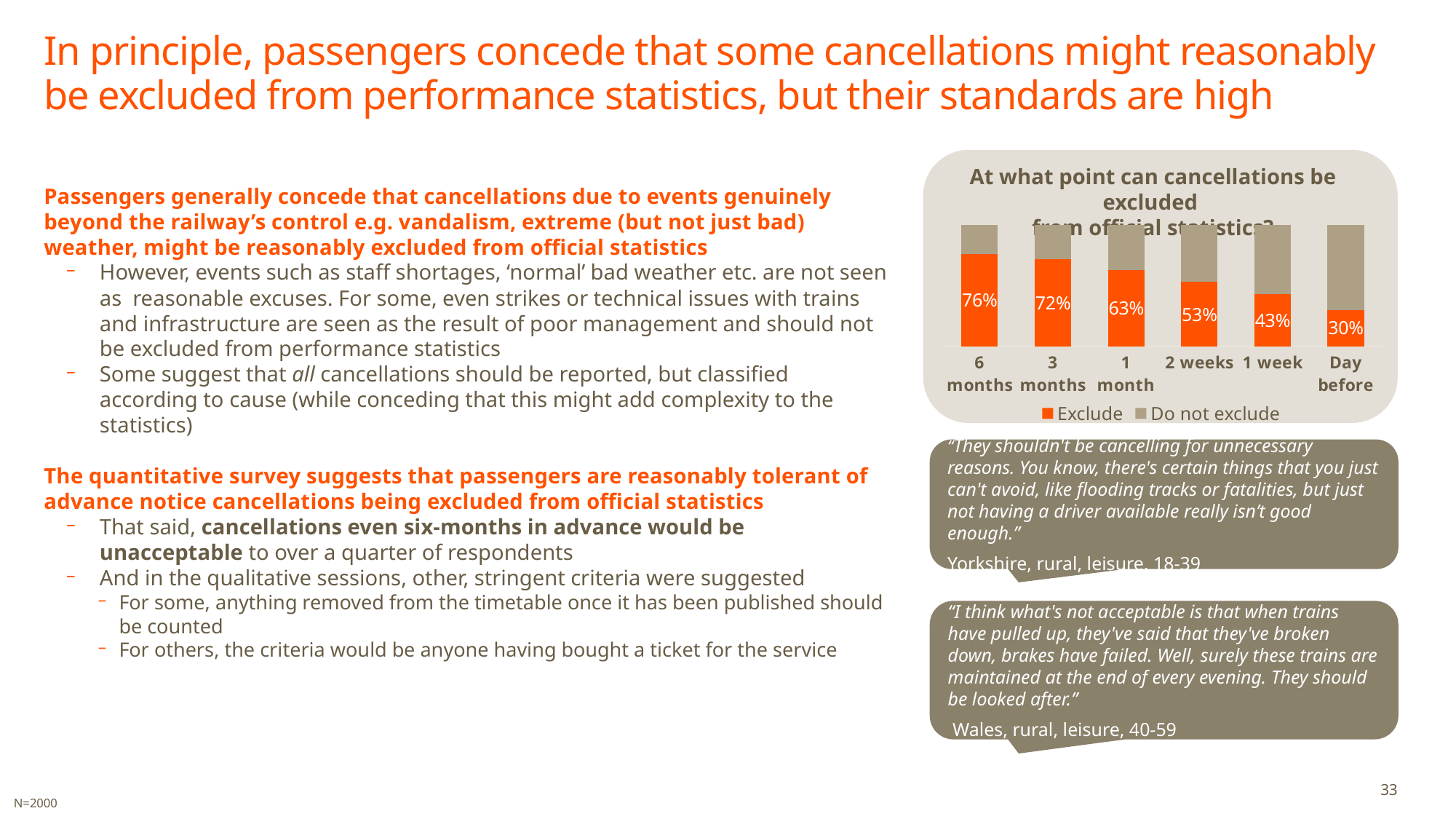
What is the 'Exclude' value for cancellations made 1 week in advance? 43% What percentage of respondents would exclude cancellations made 6 months in advance? 76% Which notice period has the highest 'Exclude' percentage? 6 months How many notice-period categories are shown on the chart? 6 What is the 'Exclude' value for cancellations made 2 weeks in advance? 53% What is the difference between the 'Exclude' values for 3 months and 1 month? 9 percentage points Does the 'Exclude' percentage rise or fall as the notice period gets shorter from left to right? Fall Which has a larger 'Exclude' share: 1 month or 2 weeks? 1 month Which notice period has the lowest 'Exclude' percentage? Day before What is the 'Exclude' value for cancellations made the day before? 30% What is the difference between the 'Exclude' values for 6 months and the day before? 46 percentage points How many series does the chart legend list? 2